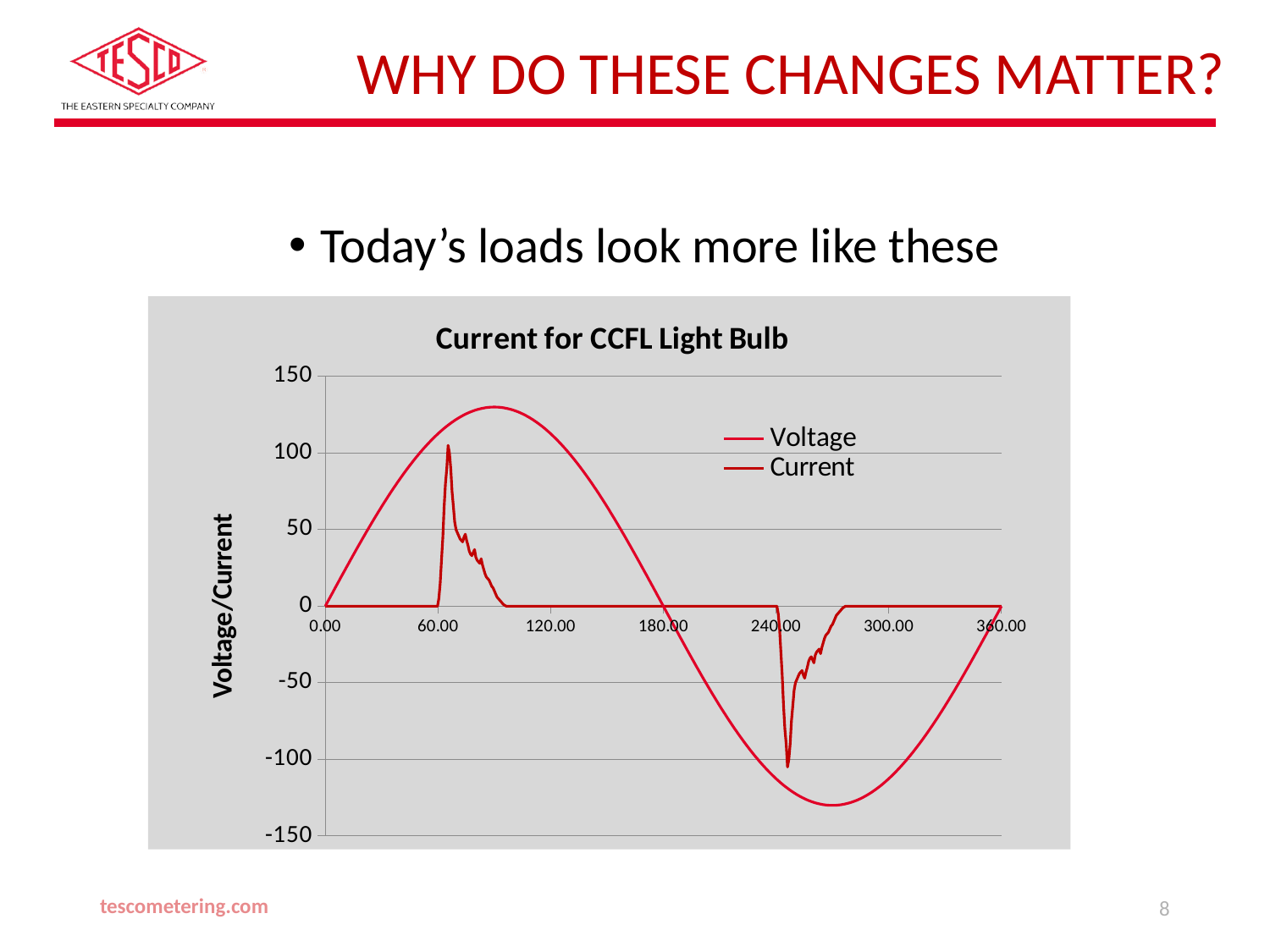
How many series does the legend list? 2 Is the lowest value of the Voltage series greater or less than -100? less Which series reaches the higher peak value, Voltage or Current? Voltage Does the Voltage series rise or fall between 0.00 and 60.00 on the x axis? rise What are the two series named in the legend? Voltage and Current Is the peak value of the Voltage series greater or less than 100? greater Is the peak value of the Current series greater or less than 150? less What is the title of the chart? Current for CCFL Light Bulb What kind of chart is shown on the slide? line chart What is the value of the Voltage series at 180.00 on the x axis? 0 What is the value of the Current series at 120.00 on the x axis? 0